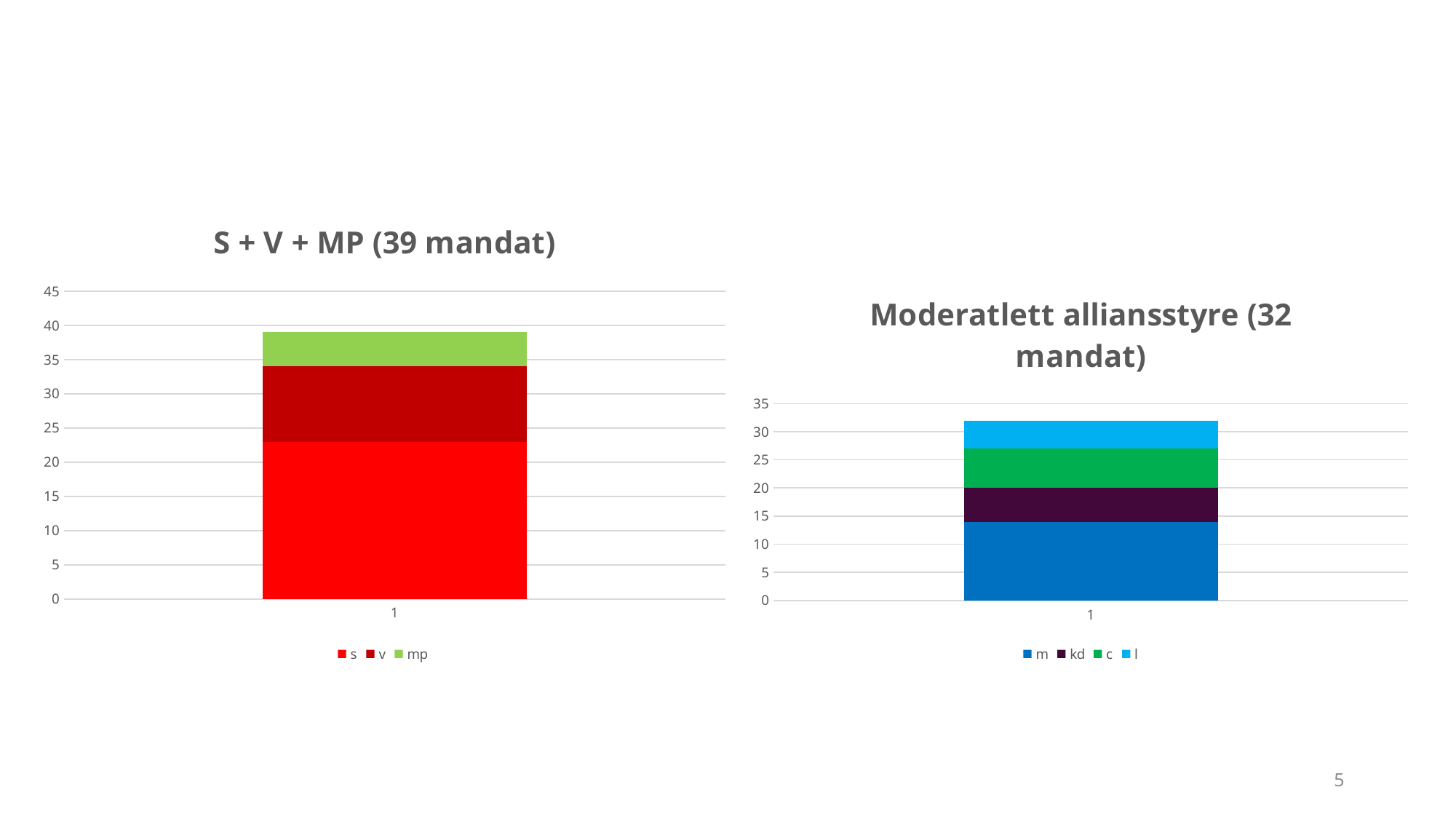
In the right chart "Moderatlett alliansstyre (32 mandat)", is the value for m greater or less than 10? greater In the left chart "S + V + MP (39 mandat)", is the value for s greater or less than 20? greater According to its title, what is the total number of mandat shown in the right chart "Moderatlett alliansstyre"? 32 How many series does the legend of the left chart "S + V + MP (39 mandat)" list? 3 In the right chart "Moderatlett alliansstyre (32 mandat)", which series has the largest segment in the stacked bar? m What type of chart is the left chart titled "S + V + MP (39 mandat)"? stacked bar chart How many series does the legend of the right chart "Moderatlett alliansstyre (32 mandat)" list? 4 In the left chart "S + V + MP (39 mandat)", which series has the largest segment in the stacked bar? s In the left chart "S + V + MP (39 mandat)", is the total height of the stacked bar greater or less than 35? greater In the left chart "S + V + MP (39 mandat)", which series has the smallest segment in the stacked bar? mp According to its title, what is the total number of mandat shown in the left chart "S + V + MP"? 39 Which stacked bar is taller: the one in the left chart "S + V + MP (39 mandat)" or the one in the right chart "Moderatlett alliansstyre (32 mandat)"? S + V + MP (39 mandat)